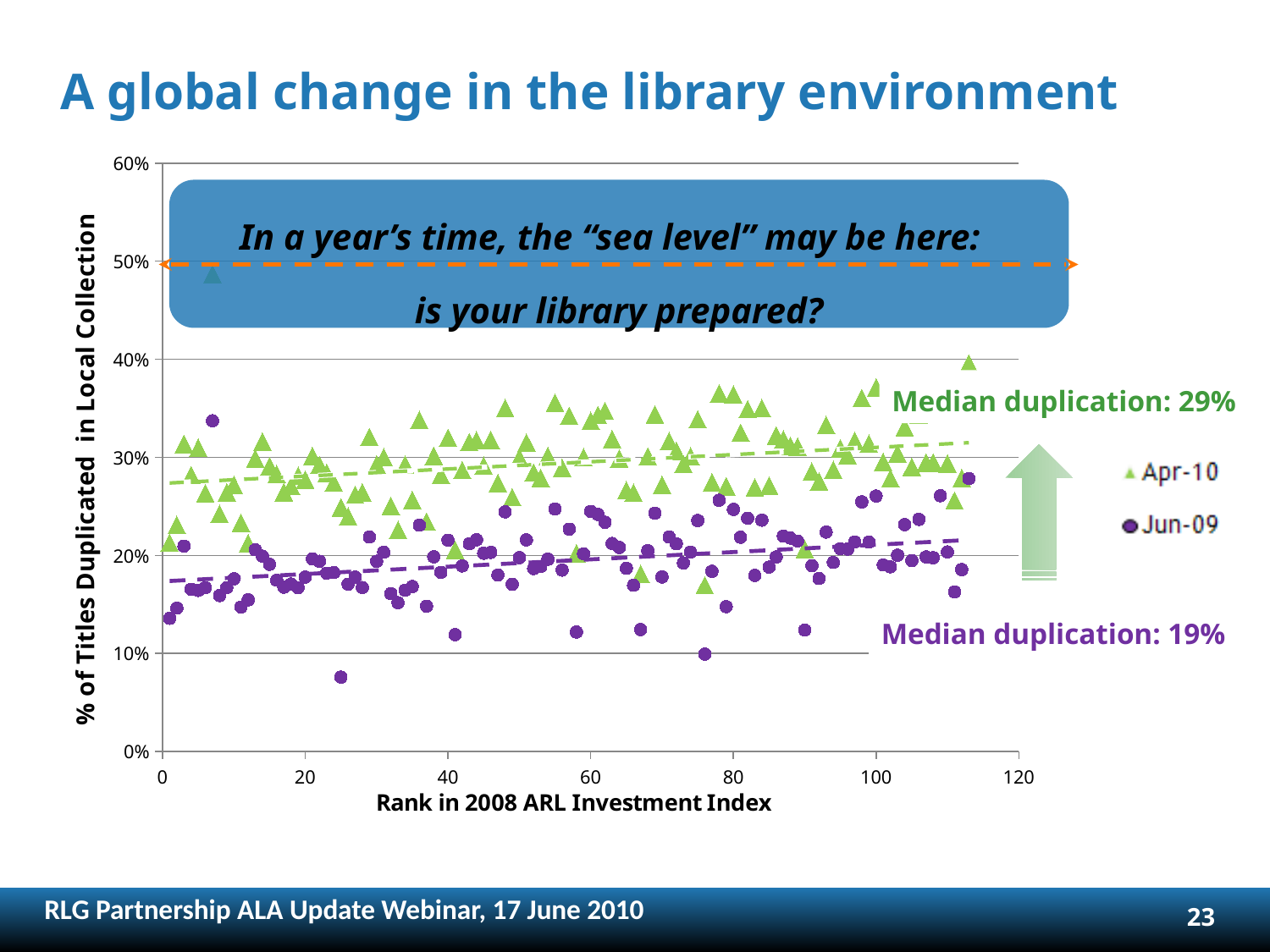
How many series does the chart legend list? 2 What kind of chart is shown on the slide? Scatter chart Is the highest Apr-10 point (near rank 7) greater or less than 40%? greater What are the two series named in the chart legend? Apr-10 and Jun-09 What is the median duplication for the Apr-10 series? 29% Is the lowest Jun-09 point (near rank 25) greater or less than 10%? less What is the label of the x axis? Rank in 2008 ARL Investment Index What is the difference between the Apr-10 median duplication and the Jun-09 median duplication? 10% What is the median duplication for the Jun-09 series? 19% Which series generally has higher values across the chart, Apr-10 or Jun-09? Apr-10 Do the dashed trend lines for both series rise or fall as rank increases along the x axis? rise Which series has the higher median duplication, Apr-10 or Jun-09? Apr-10